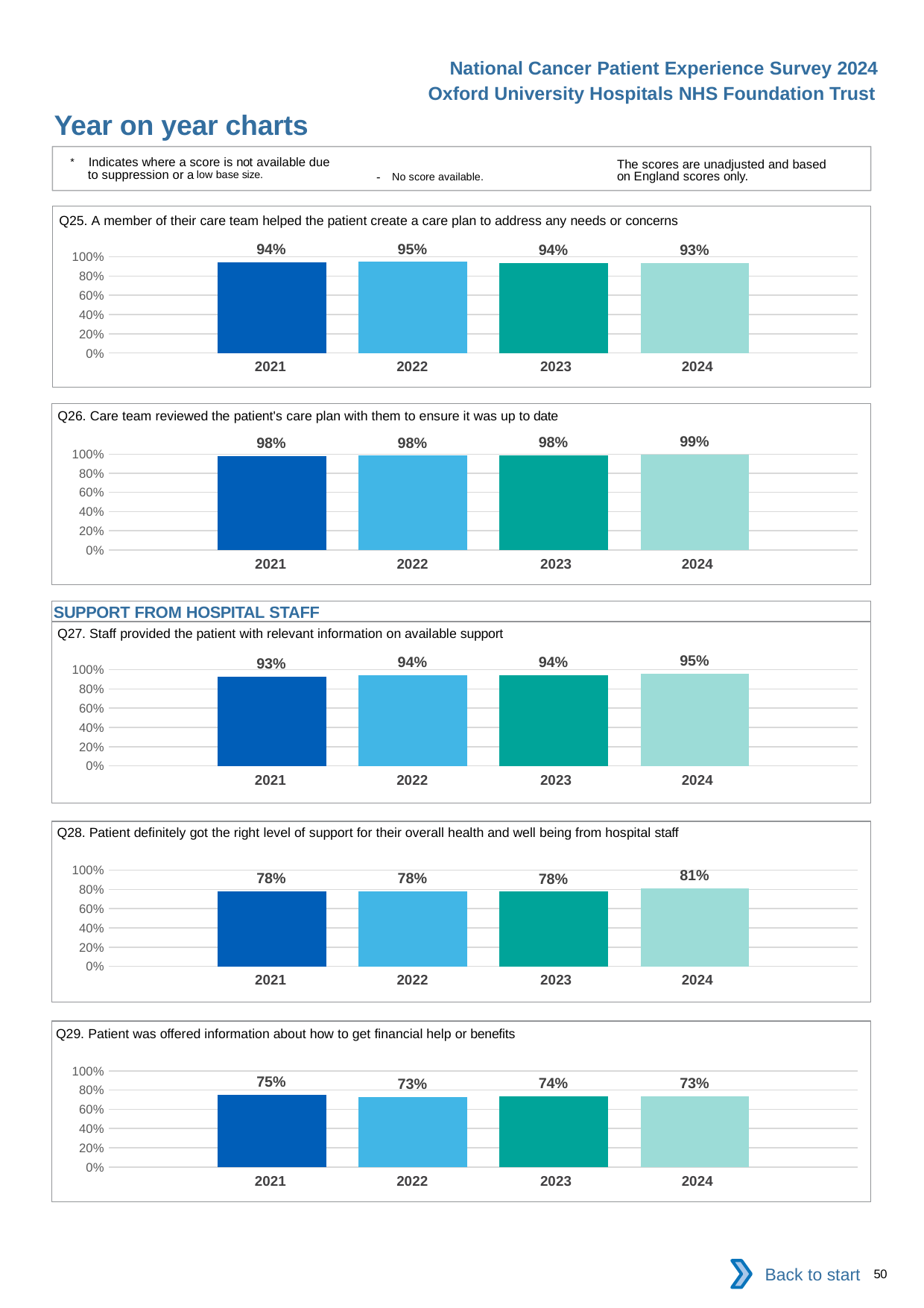
In the Q26 chart, what is the difference between the 2024 value and the 2021 value? 1% In the Q27 chart, which year has the highest value? 2024 In the Q29 chart, which year has the highest value? 2021 How many years are shown in the Q29 chart? 4 In the Q26 chart, what is the value for 2024? 99% In the Q25 chart, which year has the lowest value? 2024 In the Q28 chart, what is the difference between the 2024 value and the 2023 value? 3% In the Q27 chart, what is the value for 2021? 93% In the Q28 chart, what is the value for 2024? 81% In the Q29 chart, is the value for 2023 larger or smaller than the value for 2022? larger In the Q25 chart, what is the value for 2022? 95% What kind of chart is the Q28 chart? bar chart